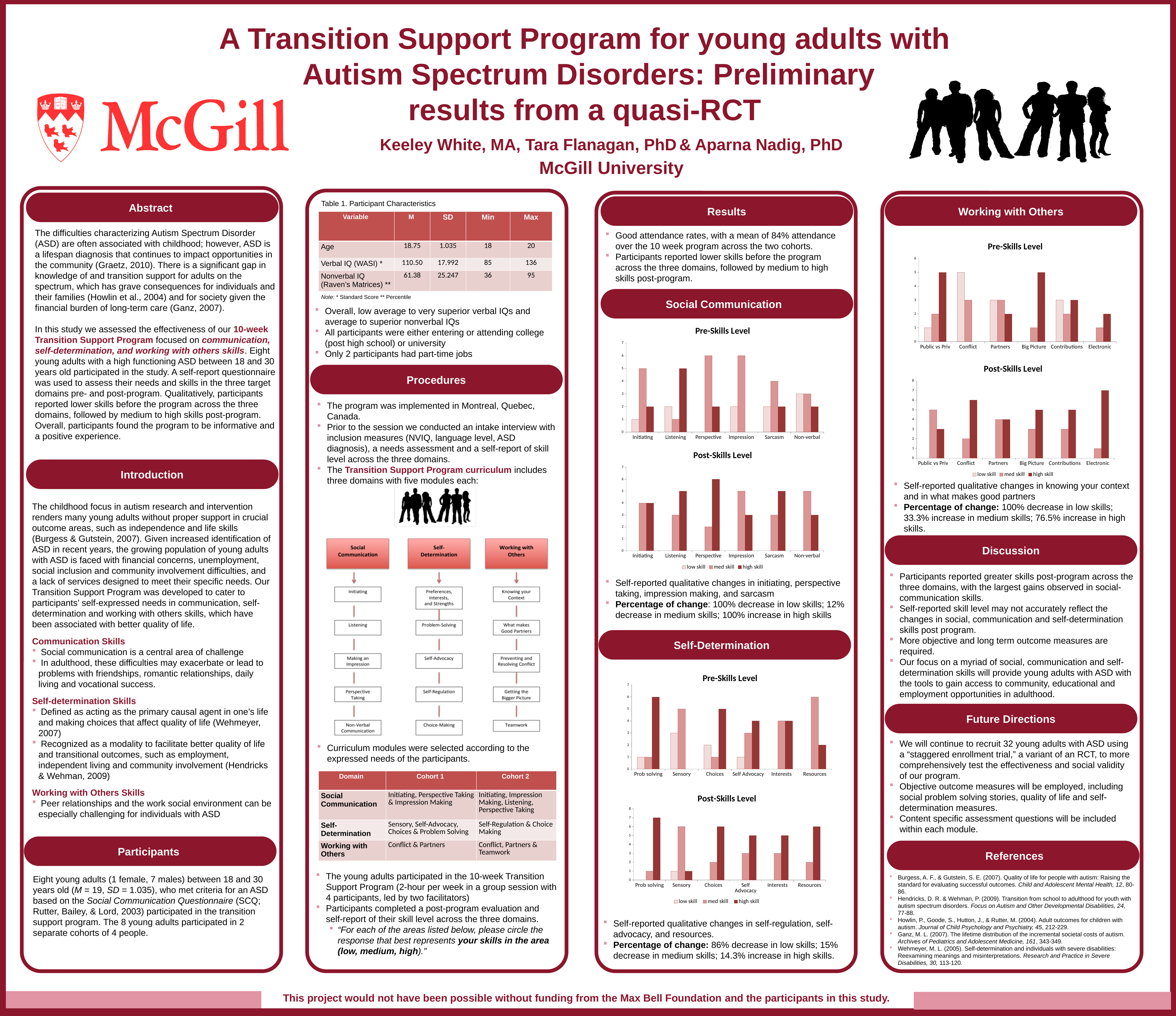
In the Working with Others Post-Skills Level chart, which category has the tallest high skill bar? Electronic In the Social Communication Pre-Skills Level chart, is the med skill value for Perspective greater or less than 4? greater What kind of chart is the Social Communication Pre-Skills Level chart? bar chart In the Self-Determination Post-Skills Level chart, which is larger for Sensory: the med skill bar or the high skill bar? med skill How many categories are shown on the x axis of the Self-Determination Pre-Skills Level chart? 6 In the Self-Determination Post-Skills Level chart, is the high skill value for Prob solving greater or less than 6? greater In the Social Communication Pre-Skills Level chart, which category has the tallest low skill bar? Non-verbal In the Social Communication Post-Skills Level chart, is the high skill value for Perspective greater or less than 4? greater In the Working with Others Pre-Skills Level chart, which category has the tallest low skill bar? Conflict What are the three legend entries for the Working with Others Post-Skills Level chart? low skill, med skill, high skill How many series does the legend list for the Social Communication Post-Skills Level chart? 3